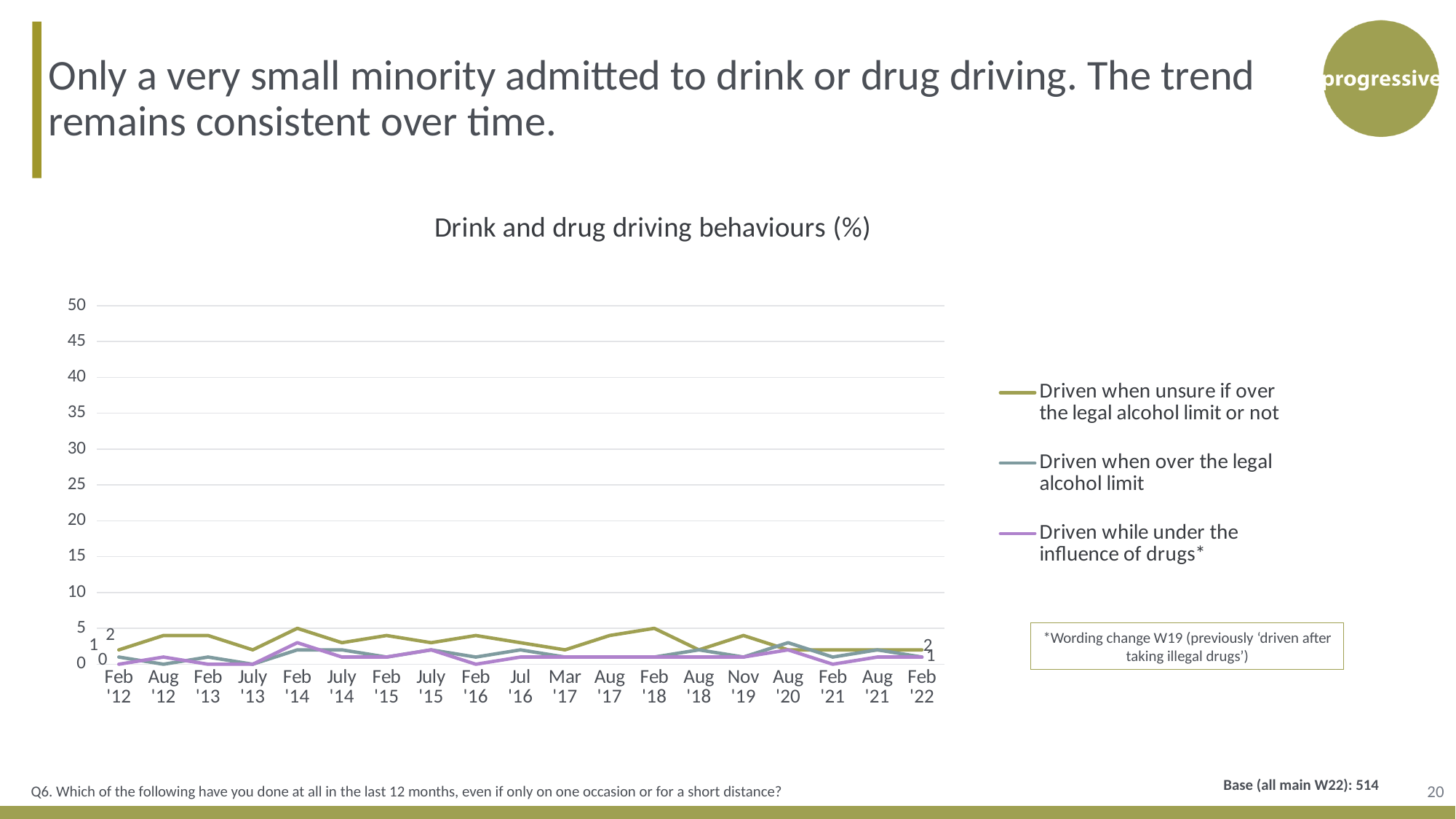
Which series is drawn in purple in the chart? Driven while under the influence of drugs* What type of chart is shown on the slide? line chart What is the value for 'Driven when unsure if over the legal alcohol limit or not' at Feb '22? 2 At Feb '12, which is larger: 'Driven when unsure if over the legal alcohol limit or not' or 'Driven while under the influence of drugs*'? Driven when unsure if over the legal alcohol limit or not What is the value for 'Driven when over the legal alcohol limit' at Feb '12? 1 Is the value for 'Driven when unsure if over the legal alcohol limit or not' at Feb '18 greater or less than 10? less What is the value for 'Driven when unsure if over the legal alcohol limit or not' at Feb '12? 2 How many series does the chart's legend list? 3 How many time points are shown along the x axis of the chart? 19 At Feb '12, what is the difference between 'Driven when unsure if over the legal alcohol limit or not' and 'Driven when over the legal alcohol limit'? 1 What is the value for 'Driven while under the influence of drugs*' at Feb '12? 0 What is the title of the chart? Drink and drug driving behaviours (%)